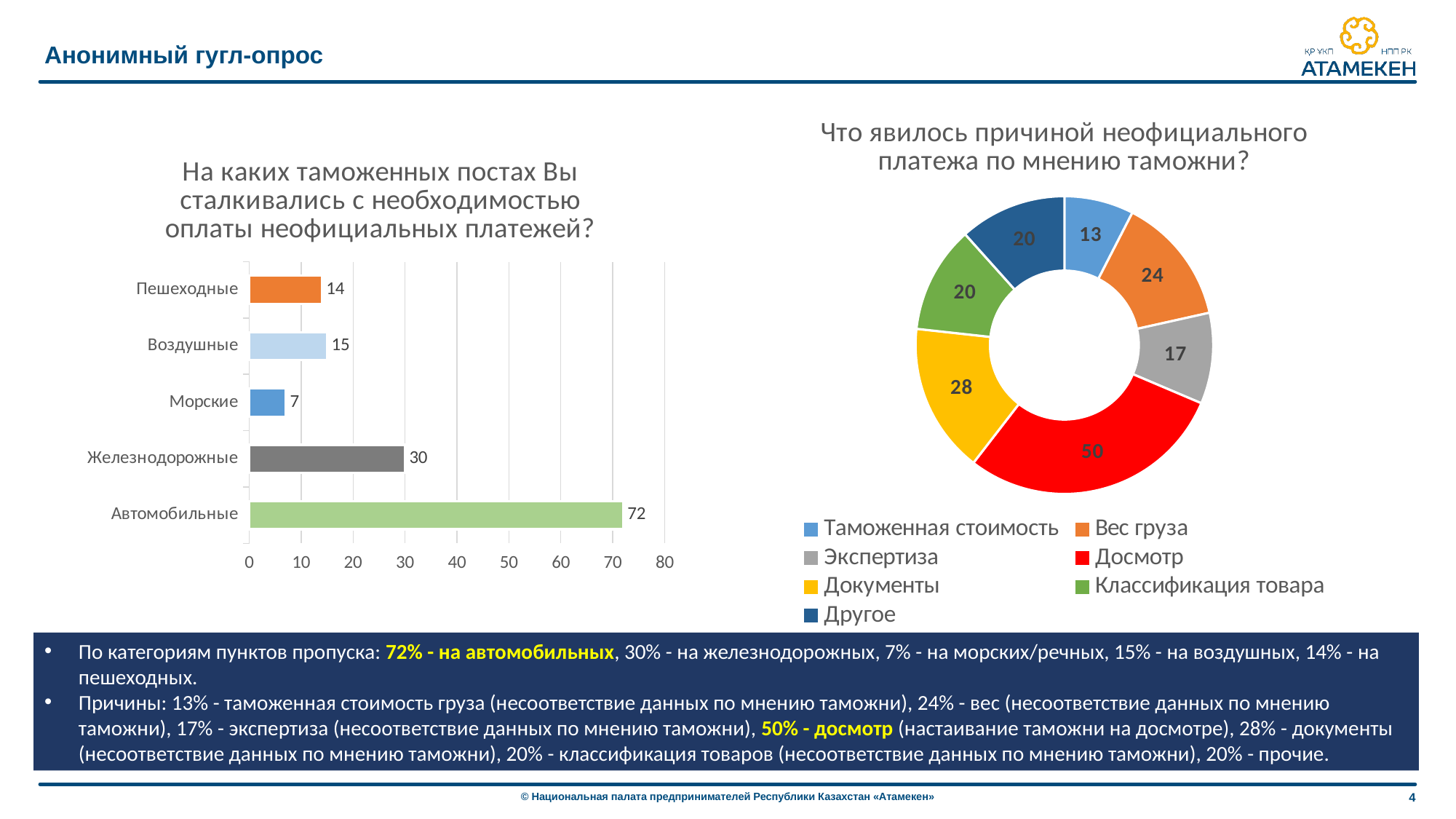
How many entries does the legend of the right chart list? 7 In the left chart, what is the difference between the values for Автомобильные and Железнодорожные? 42 In the left chart, what is the value for Автомобильные? 72 What type of chart is the chart on the left? bar chart In the left chart, what is the value for Морские? 7 In the left chart, which category has the lowest value? Морские In the right chart, what is the value for Досмотр? 50 In the left chart, which is larger: the value for Воздушные or the value for Пешеходные? Воздушные In the right chart, which category has the largest value? Досмотр In the right chart, what is the value for Экспертиза? 17 In the left chart, which category has the highest value? Автомобильные How many categories does the left bar chart show? 5